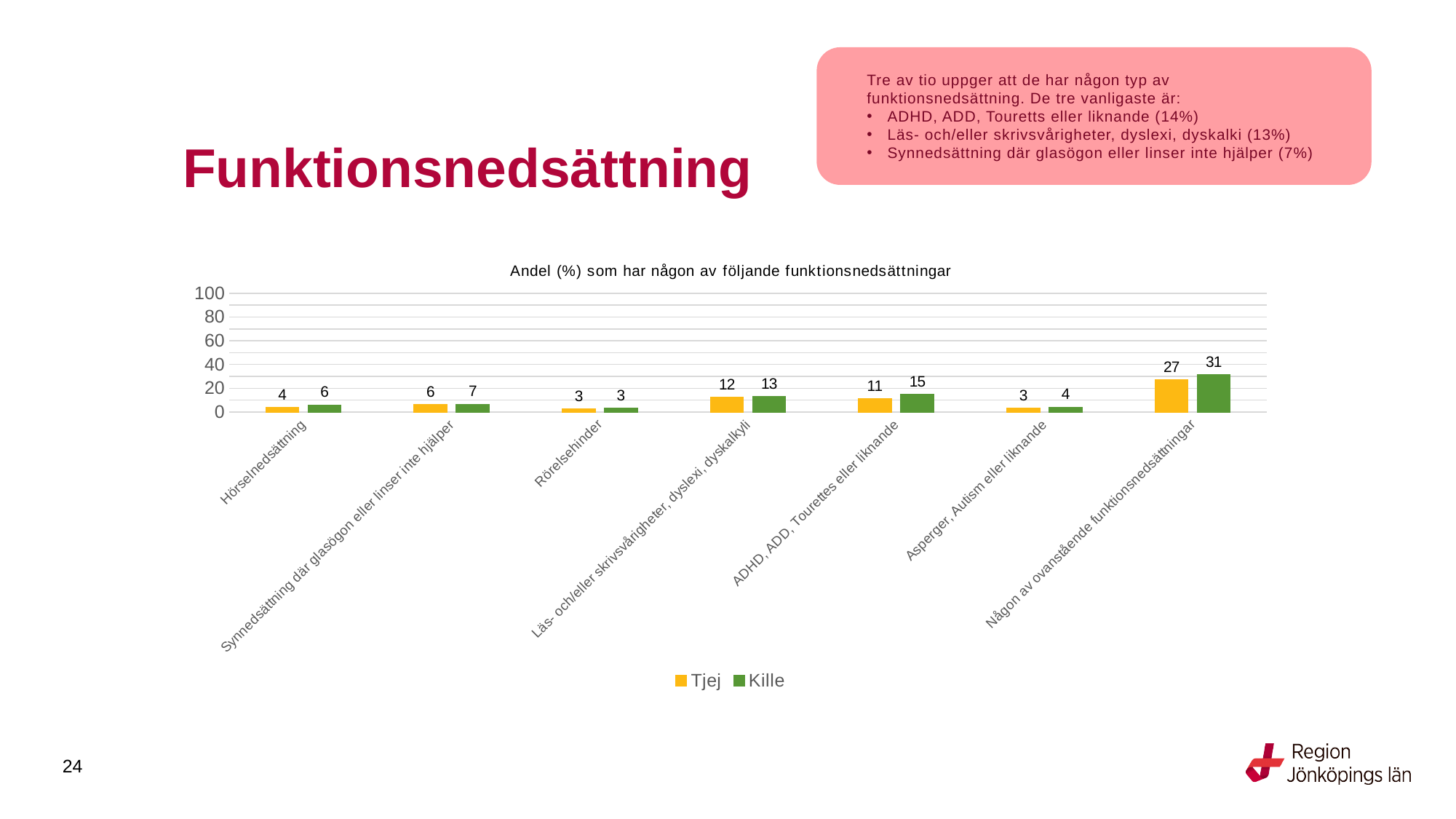
Which colour represents the Kille series in the chart? green What kind of chart is shown on the slide? bar chart What is the value for Tjej in the Hörselnedsättning category? 4 How many series does the legend list? 2 What is the title of the chart? Andel (%) som har någon av följande funktionsnedsättningar What is the difference between Kille and Tjej in the Någon av ovanstående funktionsnedsättningar category? 4 Which is larger in the Läs- och/eller skrivsvårigheter, dyslexi, dyskalkyli category: Tjej or Kille? Kille Which category has the highest value for Tjej? Någon av ovanstående funktionsnedsättningar Is the value for Kille in the Någon av ovanstående funktionsnedsättningar category greater or less than 20? greater How many categories are shown on the x axis? 7 What is the value for Kille in the ADHD, ADD, Tourettes eller liknande category? 15 What is the value for Kille in the Någon av ovanstående funktionsnedsättningar category? 31